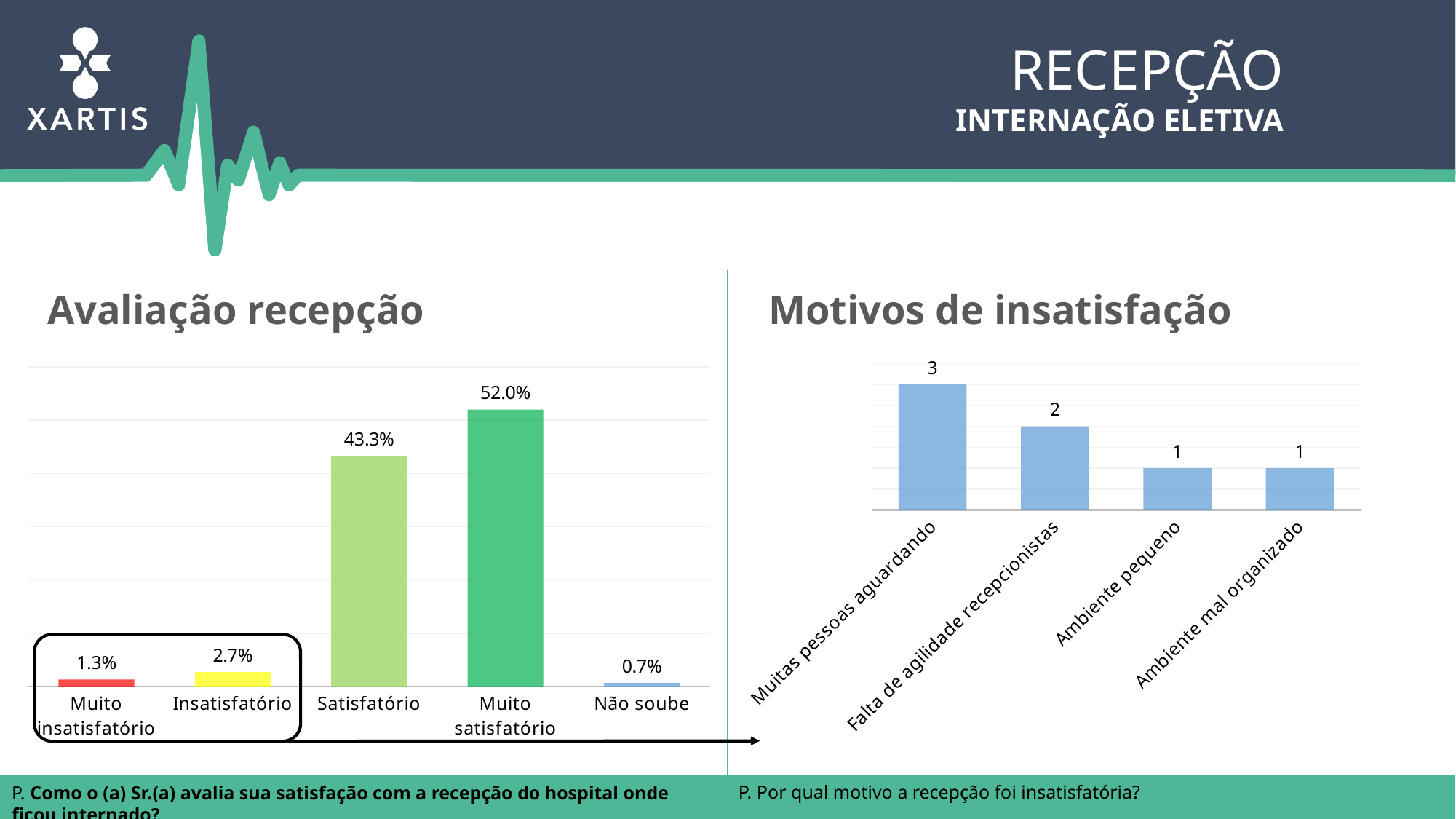
In the 'Motivos de insatisfação' chart, what is the value for 'Falta de agilidade recepcionistas'? 2 In the 'Avaliação recepção' chart, what is the value for 'Satisfatório'? 43.3% In the 'Avaliação recepção' chart, which category has the lowest value? Não soube In the 'Avaliação recepção' chart, which category has the highest value? Muito satisfatório In the 'Avaliação recepção' chart, what is the difference between 'Muito satisfatório' and 'Satisfatório'? 8.7% In the 'Avaliação recepção' chart, what is the value for 'Muito satisfatório'? 52.0% What kind of chart is the 'Motivos de insatisfação' chart? Bar chart In the 'Motivos de insatisfação' chart, do the values rise or fall from left to right? Fall In the 'Motivos de insatisfação' chart, what is the difference between 'Muitas pessoas aguardando' and 'Ambiente pequeno'? 2 How many categories are shown in the 'Avaliação recepção' chart? 5 In the 'Avaliação recepção' chart, which is larger: 'Insatisfatório' or 'Muito insatisfatório'? Insatisfatório In the 'Motivos de insatisfação' chart, which category has the highest value? Muitas pessoas aguardando